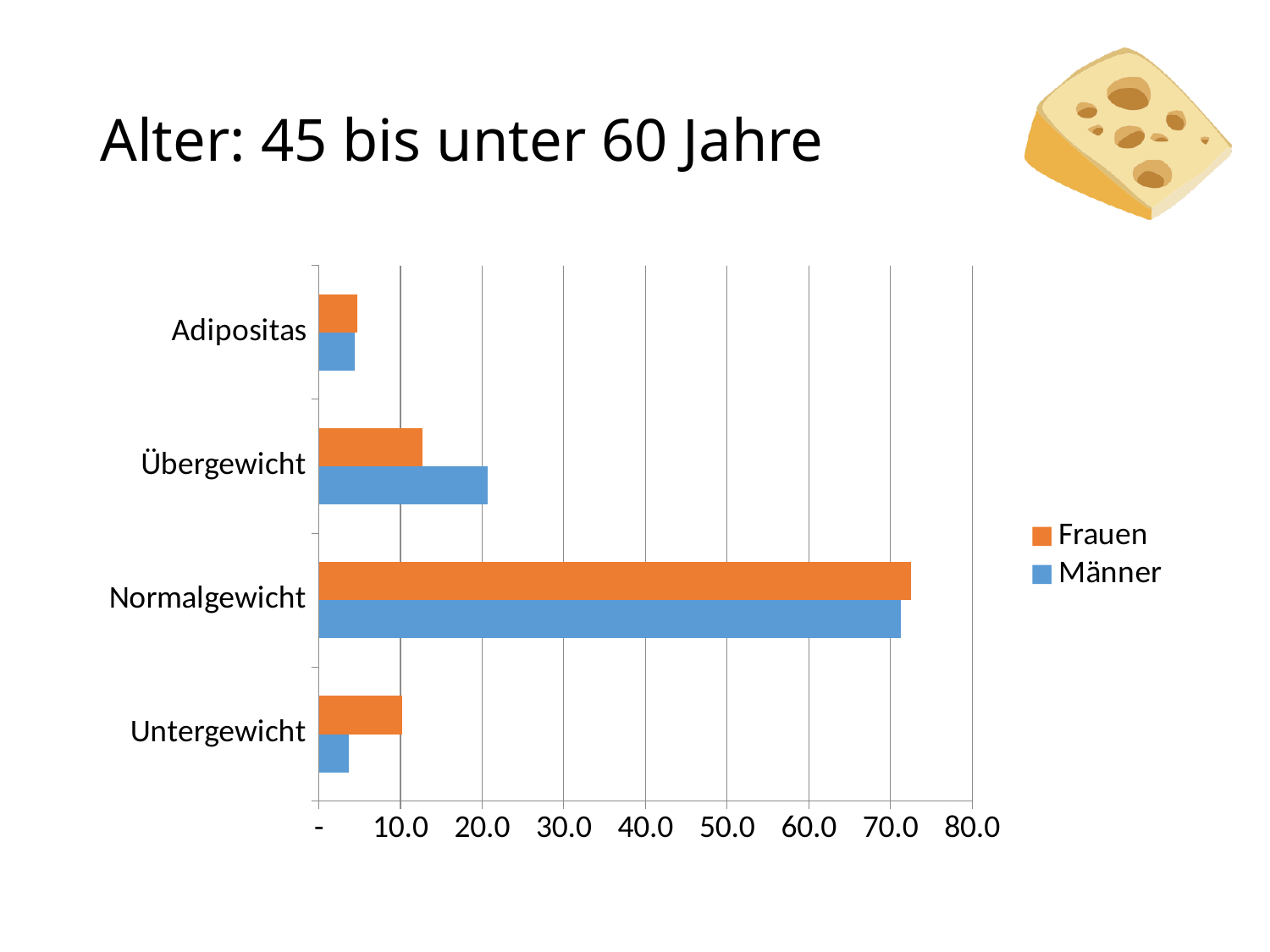
How many categories are shown on the vertical axis of the chart? 4 Is the value for Untergewicht for Männer greater or less than 10.0? less Is the value for Normalgewicht for Frauen greater or less than 70.0? greater Is the value for Übergewicht for Männer greater or less than 30.0? less For Übergewicht, which series has the larger value, Frauen or Männer? Männer What kind of chart is shown on the slide? bar chart How many series does the legend list? 2 What is the title of the slide containing the chart? Alter: 45 bis unter 60 Jahre Which category has the highest value for Frauen? Normalgewicht For Untergewicht, which series has the larger value, Frauen or Männer? Frauen Which category has the highest value for Männer? Normalgewicht Which category has the lowest value for Frauen? Adipositas